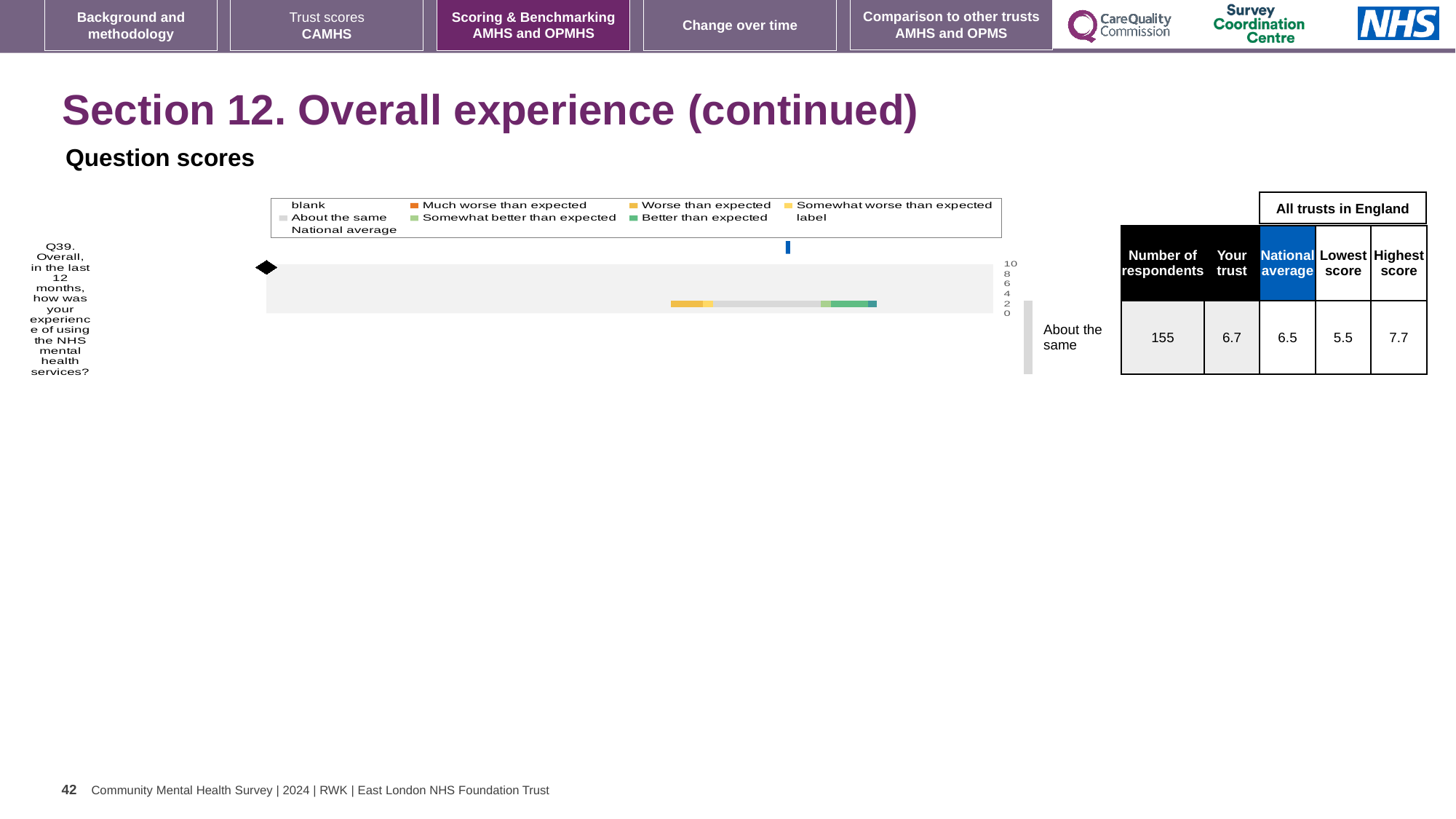
What kind of chart is shown on the slide? bar chart What is the lowest score among all trusts in England for Q39? 5.5 Which question is plotted on the chart? Q39. Overall, in the last 12 months, how was your experience of using the NHS mental health services? How many respondents answered Q39? 155 What is the national average score for Q39 in the table beside the chart? 6.5 How many question categories are plotted on the chart? 1 What is the 'Your trust' score for Q39 in the table beside the chart? 6.7 What is the highest value shown on the chart's axis? 10 What is the difference between the highest score and the lowest score for Q39? 2.2 Which is larger for Q39, the 'Your trust' score or the national average? Your trust How many entries does the chart legend list? 9 What is the highest score among all trusts in England for Q39? 7.7